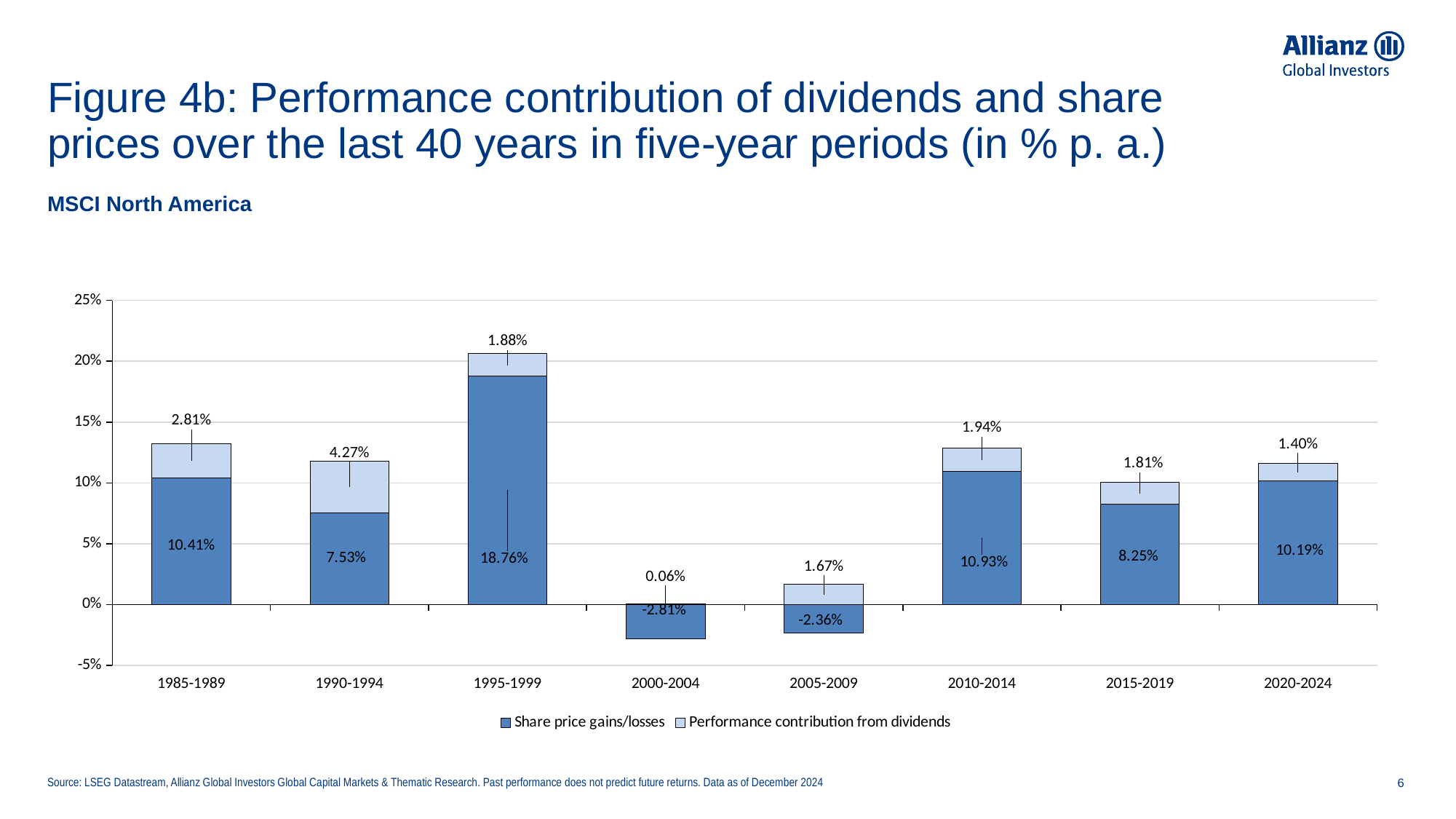
Which period has the highest performance contribution from dividends? 1990-1994 What is the difference between the share price gains/losses for 2010-2014 and 2020-2024? 0.74 percentage points What is the total of the stacked bar for 1995-1999? 20.64% What is the performance contribution from dividends for 1990-1994? 4.27% Which period has the lowest performance contribution from dividends? 2000-2004 What is the share price gains/losses value for 2005-2009? -2.36% What is the share price gains/losses value for 1995-1999? 18.76% How many five-year periods are shown on the x axis? 8 How many series does the legend list? 2 Which is larger, the share price gains/losses for 1985-1989 or for 2015-2019? 1985-1989 Is the share price gains/losses value for 1995-1999 greater or less than 15%? greater Which period has the highest share price gains/losses? 1995-1999